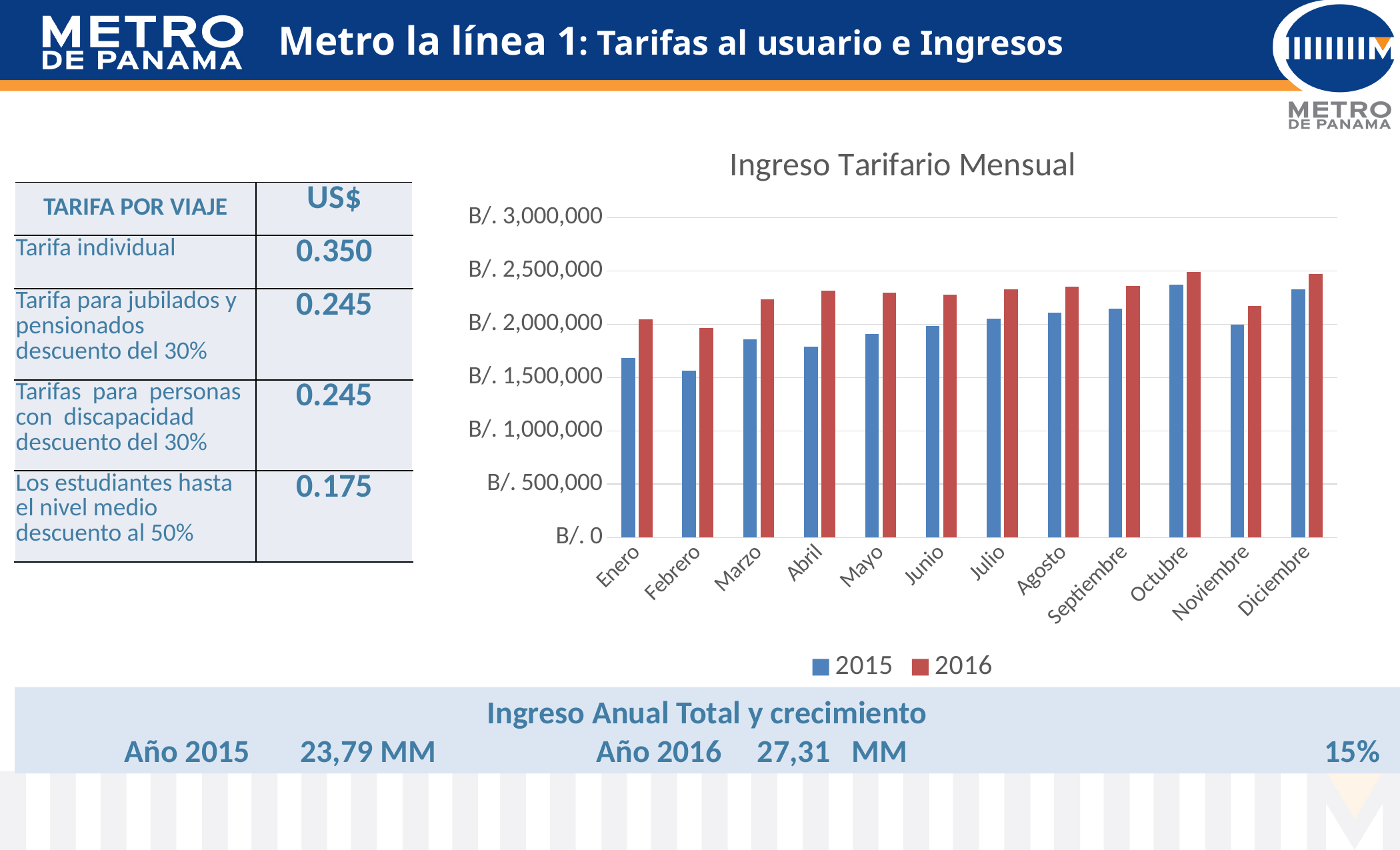
Which month has the lowest value for the 2015 series? Febrero Is the 2015 value for Febrero greater or less than B/. 1,500,000? greater What kind of chart is shown on the slide? bar chart Which colour represents the 2016 series in the chart? red Is the 2016 value for Marzo greater or less than B/. 2,000,000? greater What is the title of the chart? Ingreso Tarifario Mensual Is the 2015 value for Abril greater or less than B/. 2,000,000? less Which month has the lowest value for the 2016 series? Febrero In Abril, which series has the larger value, 2015 or 2016? 2016 In Enero, which series has the larger value, 2015 or 2016? 2016 How many series does the chart legend list? 2 How many months are shown on the x axis of the chart? 12